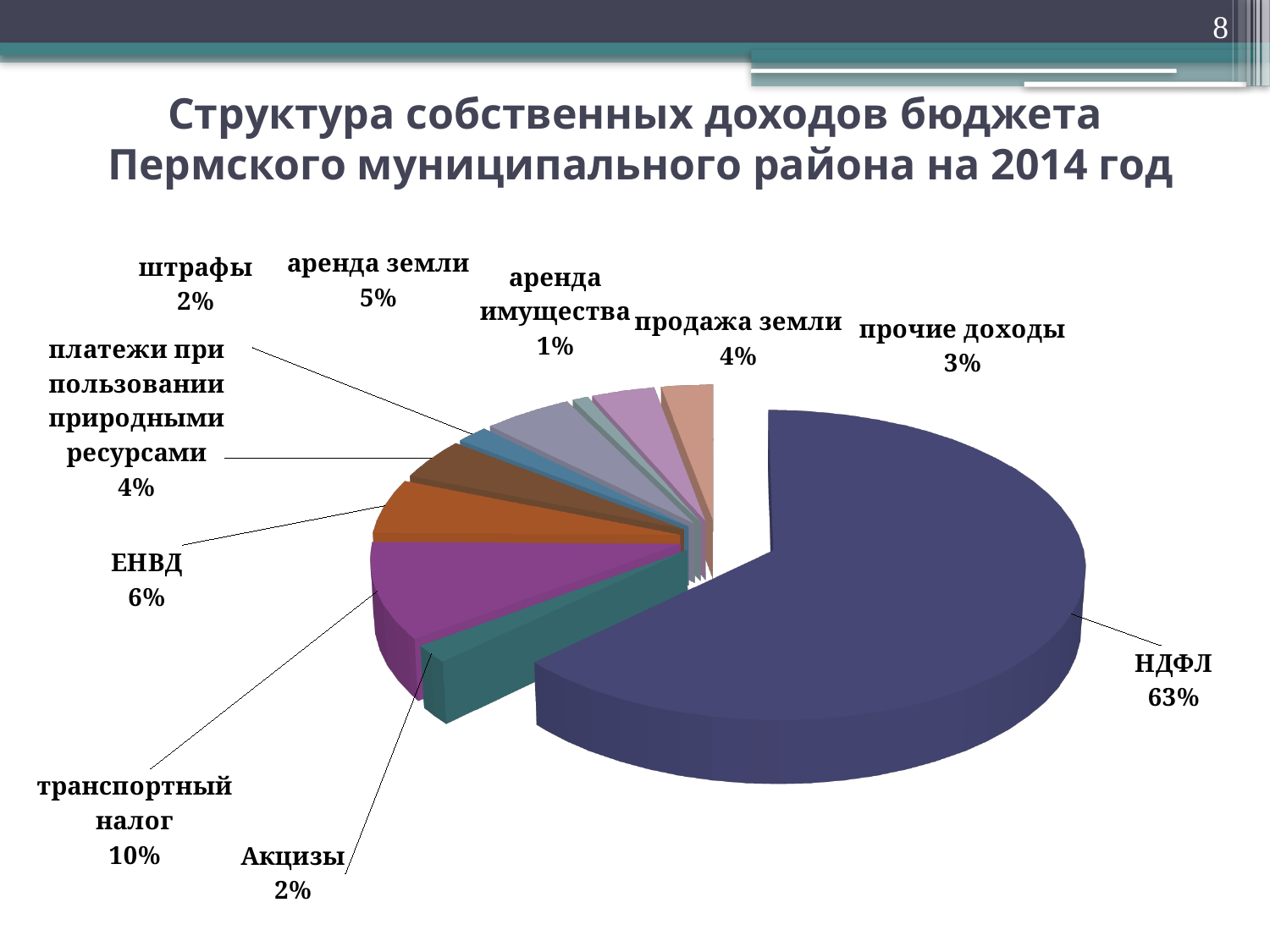
What is the difference between the shares of НДФЛ and транспортный налог? 53% What share of the budget's own revenues does НДФЛ account for? 63% What is the title of the chart on the slide? Структура собственных доходов бюджета Пермского муниципального района на 2014 год What kind of chart is shown on the slide? pie chart What is the value shown for аренда имущества? 1% Which is larger, the share of ЕНВД or the share of продажа земли? ЕНВД What is the value shown for транспортный налог? 10% Which category has the largest share of the pie? НДФЛ Which category has the smallest share of the pie? аренда имущества How many categories are shown in the pie chart? 10 What is the value shown for аренда земли? 5% What is the value shown for ЕНВД? 6%